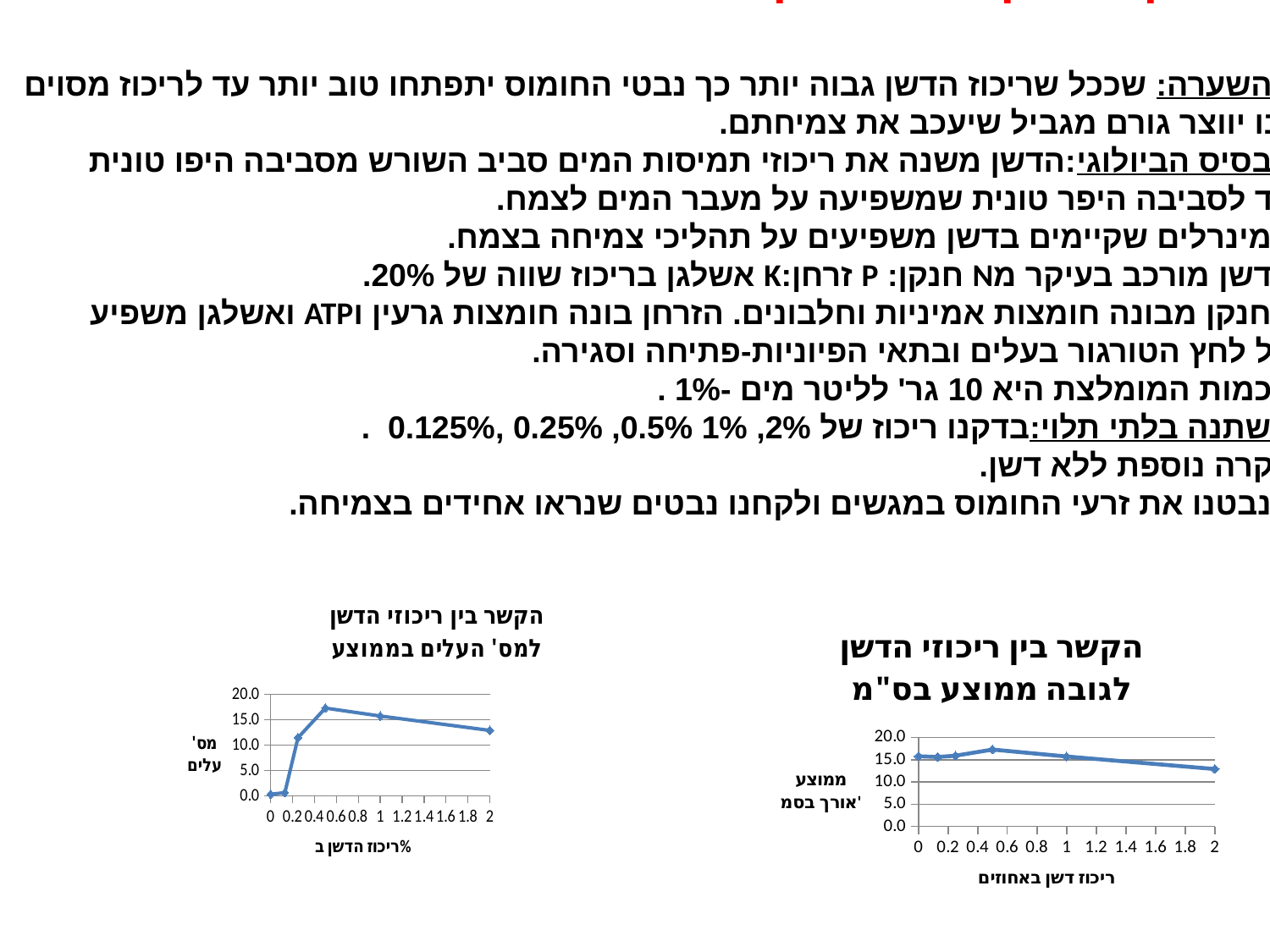
On the right chart (average height), is the value at concentration 2 greater or less than 15.0? less On the right chart (average height), at which fertilizer concentration is the value lowest? 2 What is the y-axis label of the left chart? מס' עלים On the left chart (number of leaves), which is larger: the value at concentration 0.5 or at concentration 2? 0.5 On the right chart (average height), which is larger: the value at concentration 0 or at concentration 2? 0 What kind of chart is the left chart titled 'הקשר בין ריכוזי הדשן למס' העלים בממוצע'? line chart On the left chart (number of leaves), is the value at concentration 2 greater or less than 10.0? greater On the left chart (number of leaves), is the value at concentration 0.5 greater or less than 15.0? greater On the left chart (number of leaves), at which fertilizer concentration is the value highest? 0.5 What is the x-axis label of the right chart? ריכוז דשן באחוזים How many data points are plotted on the right chart titled 'הקשר בין ריכוזי הדשן לגובה ממוצע בס"מ'? 6 On the right chart (average height), do the values rise or fall as the concentration increases from 0.5 to 2? fall